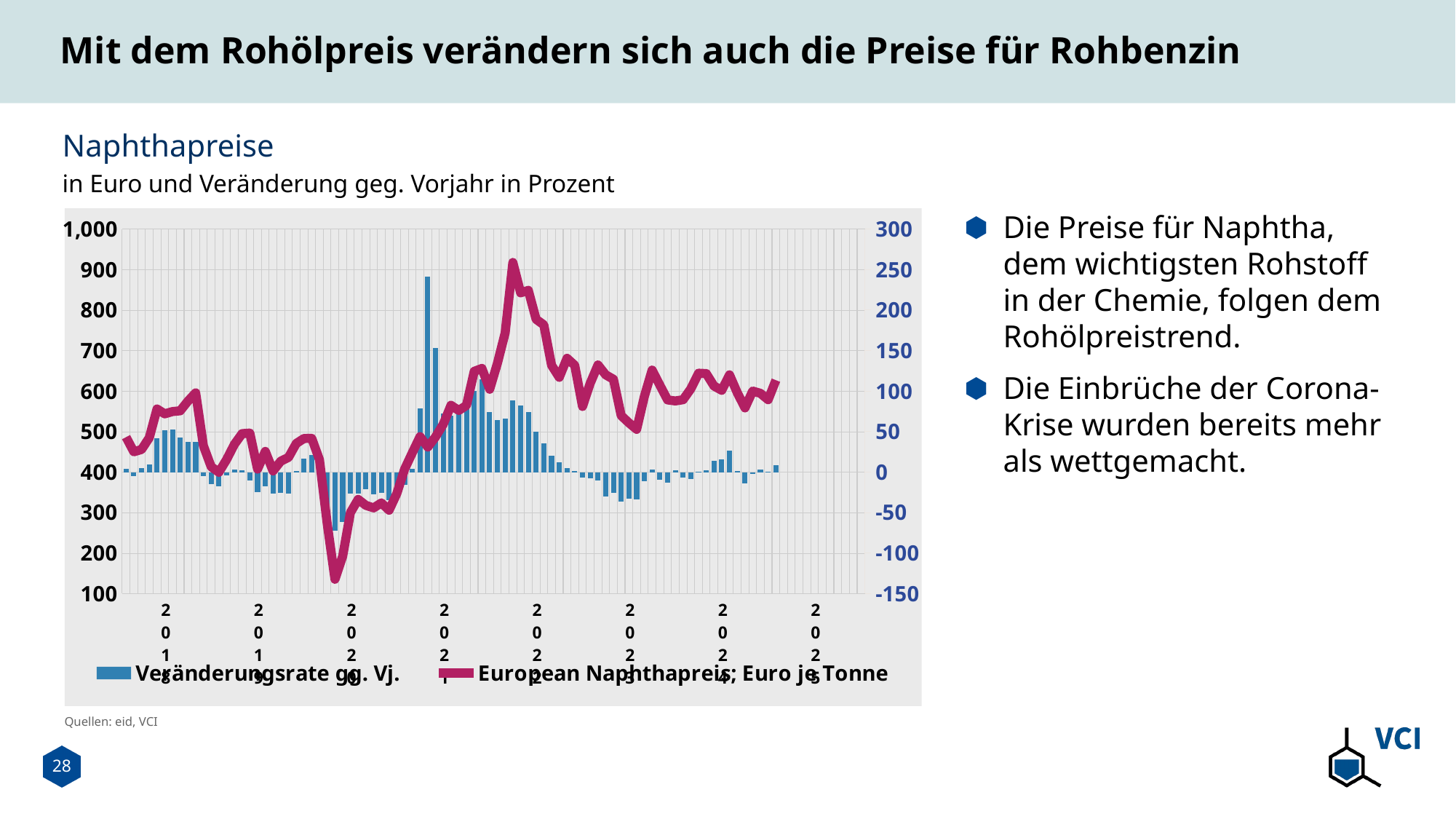
What is the title of the chart? Naphthapreise Is the lowest point of the European Naphthapreis line in 2020 greater or less than 200 Euro je Tonne? less How many series does the chart legend list? 2 What is the lowest value shown on the right vertical axis? -150 Is the peak of the European Naphthapreis line in 2022 greater or less than 800 Euro je Tonne? greater What is the highest value shown on the left vertical axis? 1,000 Which series is drawn as a line in the chart? European Naphthapreis; Euro je Tonne What kind of chart is shown on the slide? A combined bar and line chart Does the European Naphthapreis line rise or fall between its low in 2020 and its peak in 2022? rise Is the tallest bar of the Veränderungsrate gg. Vj. series in 2021 greater or less than 200 on the right axis? greater Which is higher on the European Naphthapreis line: the peak in 2022 or the low in 2020? The peak in 2022